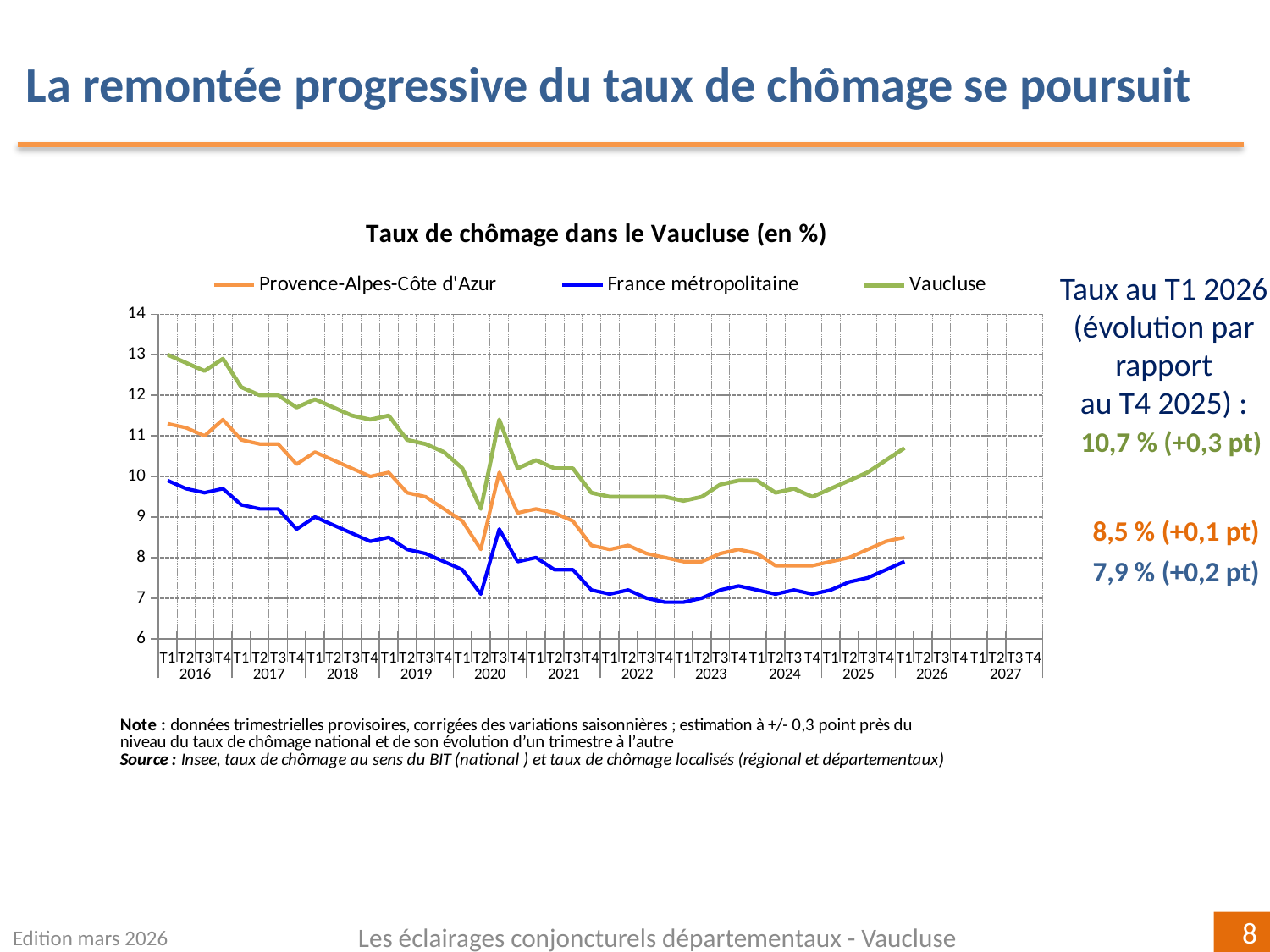
What kind of chart is shown on the slide? line chart By how many points did the Vaucluse rate change between T4 2025 and T1 2026? +0,3 pt At T1 2026, which is higher: the rate for Provence-Alpes-Côte d'Azur or for France métropolitaine? Provence-Alpes-Côte d'Azur What is the difference between the Vaucluse rate and the France métropolitaine rate at T1 2026? 2,8 points What is the title of the chart? Taux de chômage dans le Vaucluse (en %) Is the value for France métropolitaine at T2 2020 greater or less than 8? less Which series has the highest values across the whole period shown? Vaucluse What is the unemployment rate for Provence-Alpes-Côte d'Azur at T1 2026? 8,5 % What is the unemployment rate for France métropolitaine at T1 2026? 7,9 % Is the value for Vaucluse at T1 2016 greater or less than 12? greater How many series does the legend of the chart list? 3 What is the unemployment rate for Vaucluse at T1 2026? 10,7 %